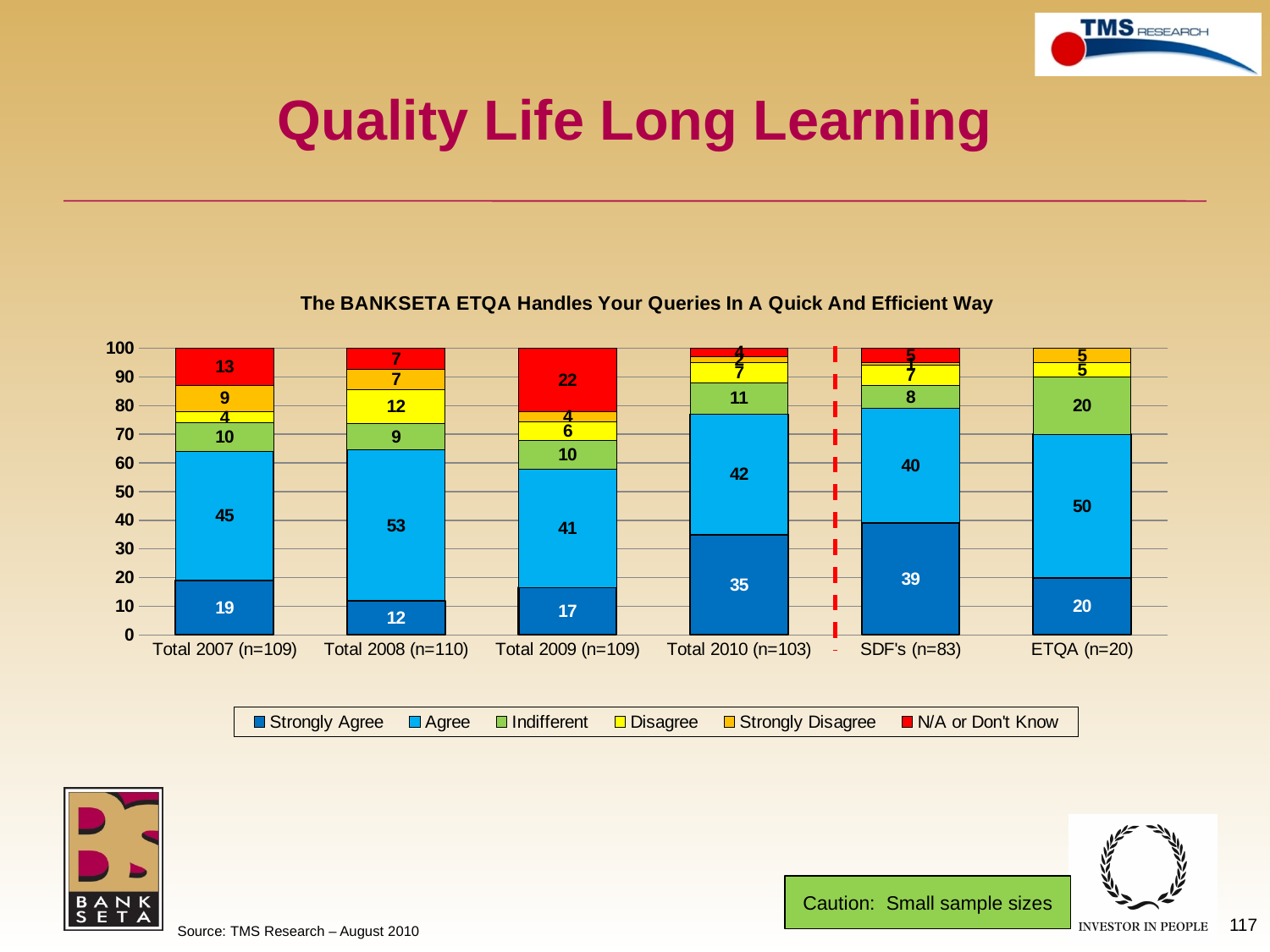
What is the value for Strongly Agree in the SDF's (n=83) bar? 39 Which has the larger Indifferent value, ETQA (n=20) or Total 2007 (n=109)? ETQA (n=20) What is the value for Agree in the Total 2008 (n=110) bar? 53 What is the value for Disagree in the Total 2008 (n=110) bar? 12 What is the value for N/A or Don't Know in the Total 2009 (n=109) bar? 22 How many series does the legend list? 6 Which category has the lowest Strongly Agree value? Total 2008 (n=110) What is the difference between the Strongly Agree values for Total 2010 (n=103) and Total 2007 (n=109)? 16 Which category has the highest Agree value? Total 2008 (n=110) What kind of chart is shown on the slide? Stacked bar chart What is the title of the chart? The BANKSETA ETQA Handles Your Queries In A Quick And Efficient Way What is the value for Strongly Disagree in the Total 2007 (n=109) bar? 9